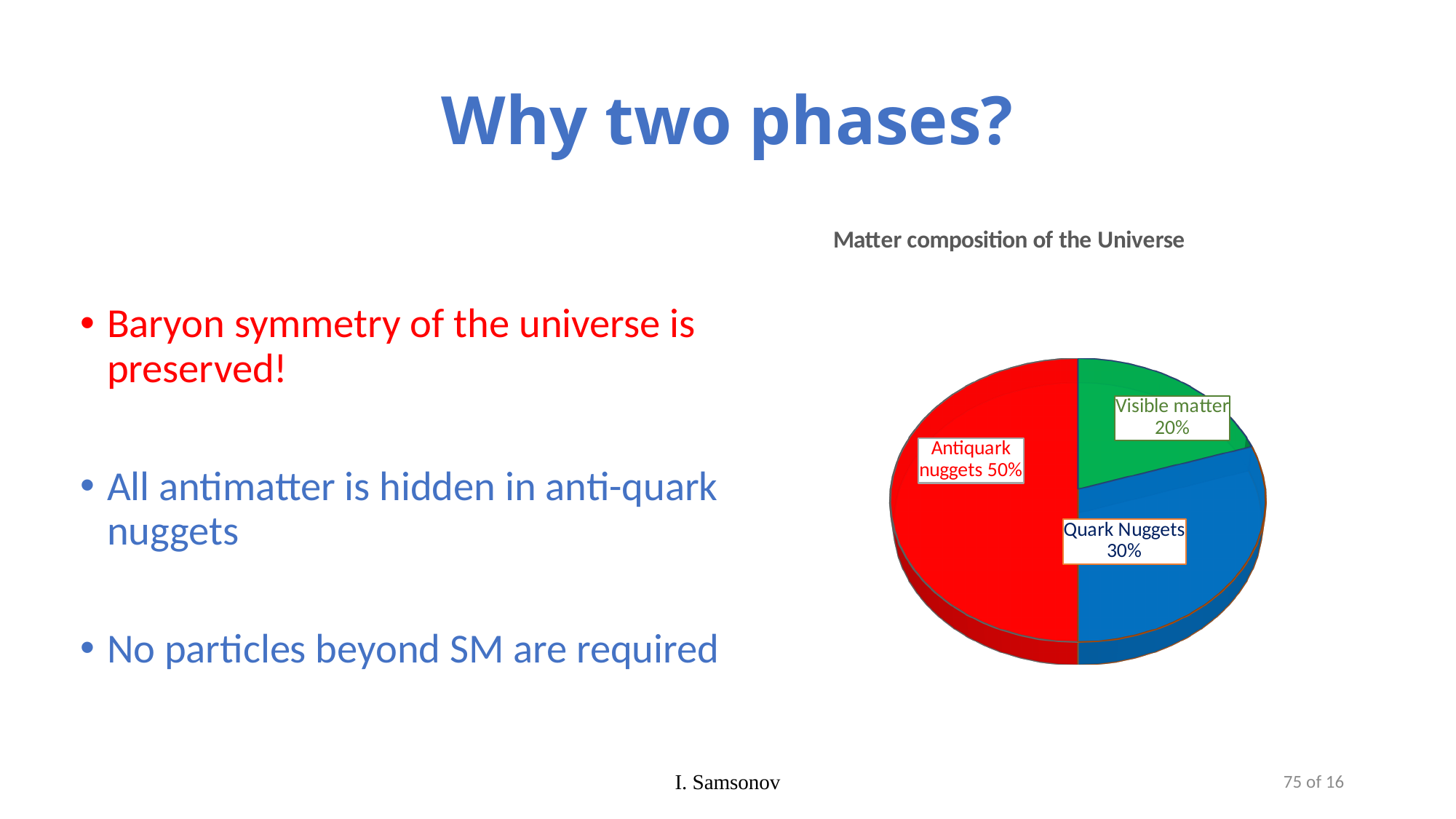
What share of the pie is Quark Nuggets? 30% What colour is the Antiquark nuggets slice? red What share of the pie is Antiquark nuggets? 50% How many slices does the pie chart have? 3 What kind of chart is shown on the slide? pie chart What share of the pie is Visible matter? 20% What is the difference between the Antiquark nuggets share and the Quark Nuggets share? 20% What is the title of the chart? Matter composition of the Universe Which is larger, the Quark Nuggets slice or the Visible matter slice? Quark Nuggets What is the difference between the Quark Nuggets share and the Visible matter share? 10% Which slice of the pie chart is the largest? Antiquark nuggets Which slice of the pie chart is the smallest? Visible matter